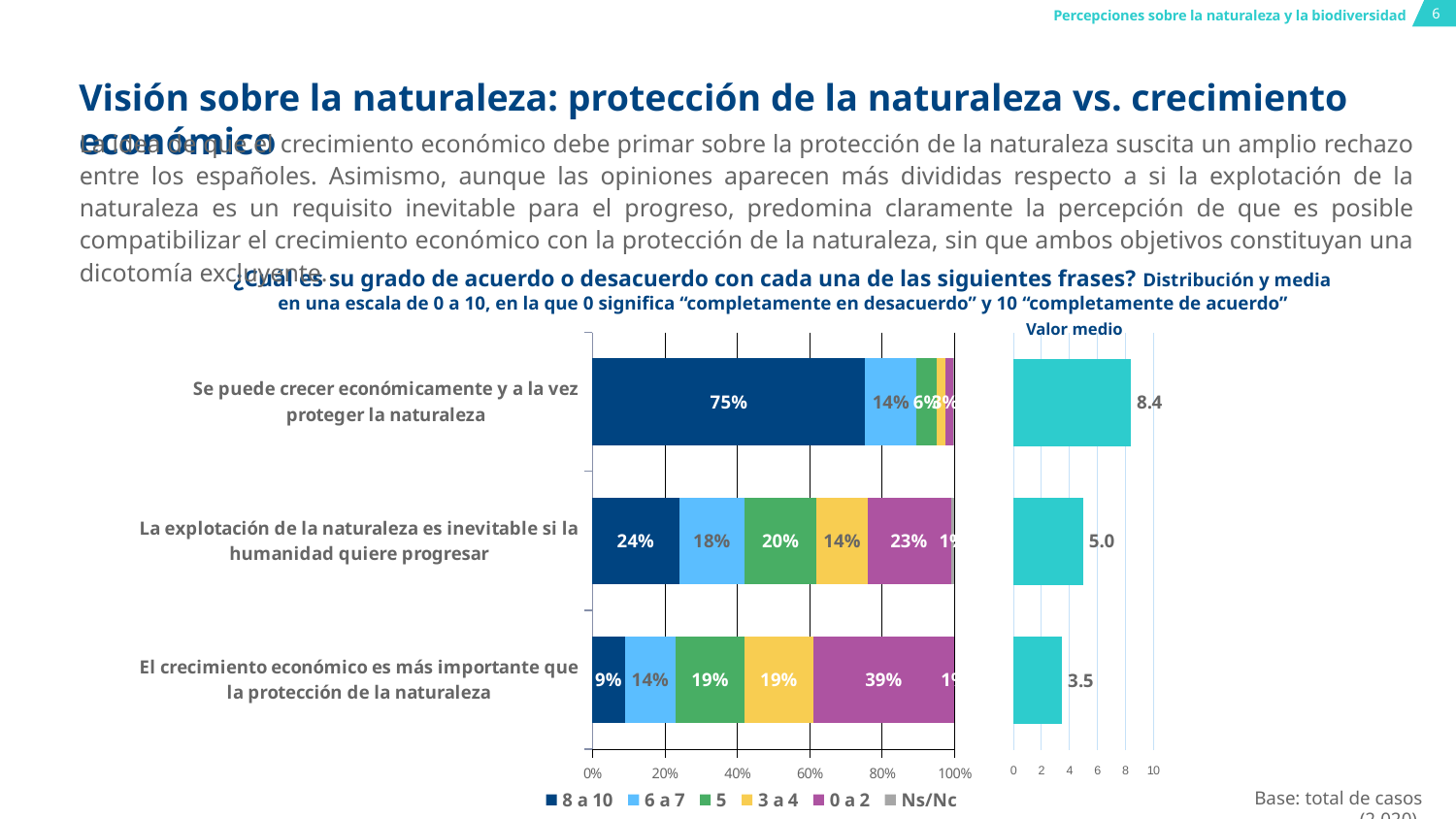
In the stacked bar chart, what percentage of respondents gave '6 a 7' for 'La explotación de la naturaleza es inevitable si la humanidad quiere progresar'? 18% What type of chart is used to show the distribution of agreement with the three statements? Stacked bar chart In the 'Valor medio' chart, what is the difference between the mean values for 'Se puede crecer económicamente y a la vez proteger la naturaleza' and 'El crecimiento económico es más importante que la protección de la naturaleza'? 4.9 In the 'Valor medio' chart, which statement has the highest mean value? Se puede crecer económicamente y a la vez proteger la naturaleza In the 'Valor medio' chart, what is the mean value for 'El crecimiento económico es más importante que la protección de la naturaleza'? 3.5 In the stacked bar chart, which is larger for 'La explotación de la naturaleza es inevitable si la humanidad quiere progresar': the '8 a 10' share or the '3 a 4' share? 8 a 10 In the 'Valor medio' chart, which statement has the lowest mean value? El crecimiento económico es más importante que la protección de la naturaleza In the stacked bar chart, what percentage of respondents gave '0 a 2' for 'El crecimiento económico es más importante que la protección de la naturaleza'? 39% How many series does the legend of the stacked bar chart list? 6 In the 'Valor medio' chart, what is the mean value for 'Se puede crecer económicamente y a la vez proteger la naturaleza'? 8.4 In the stacked bar chart, what percentage of respondents gave '8 a 10' for 'Se puede crecer económicamente y a la vez proteger la naturaleza'? 75% In the 'Valor medio' chart, what is the mean value for 'La explotación de la naturaleza es inevitable si la humanidad quiere progresar'? 5.0